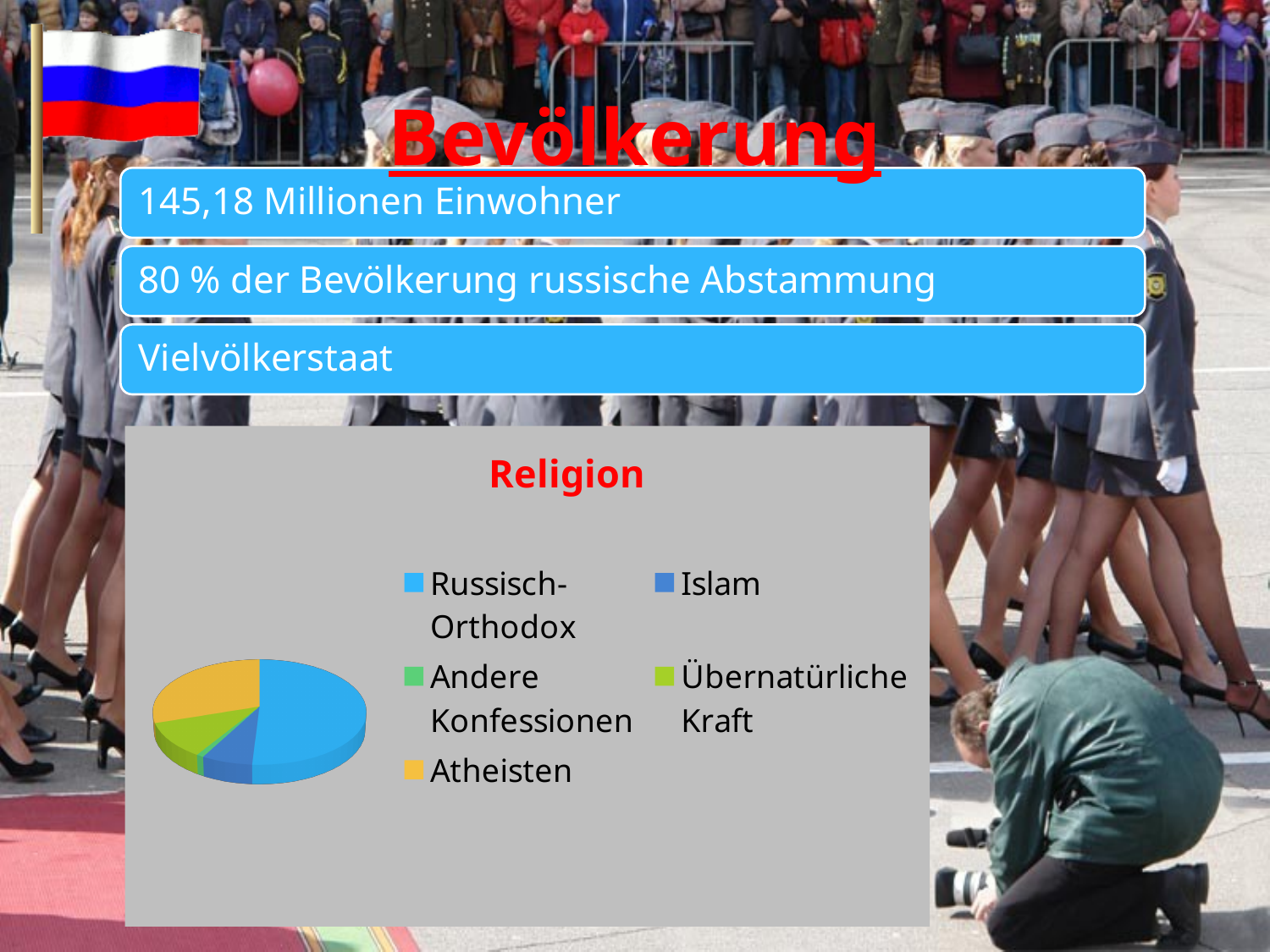
How many categories does the pie chart show? 5 What colour is the Russisch-Orthodox slice in the pie chart? light blue Which slice is larger, Russisch-Orthodox or Islam? Russisch-Orthodox How many entries does the chart legend list? 5 What kind of chart is shown on the slide? pie chart Which category has the largest slice of the pie? Russisch-Orthodox Which slice is larger, Atheisten or Islam? Atheisten What is the title of the chart? Religion Which slice is larger, Russisch-Orthodox or Atheisten? Russisch-Orthodox